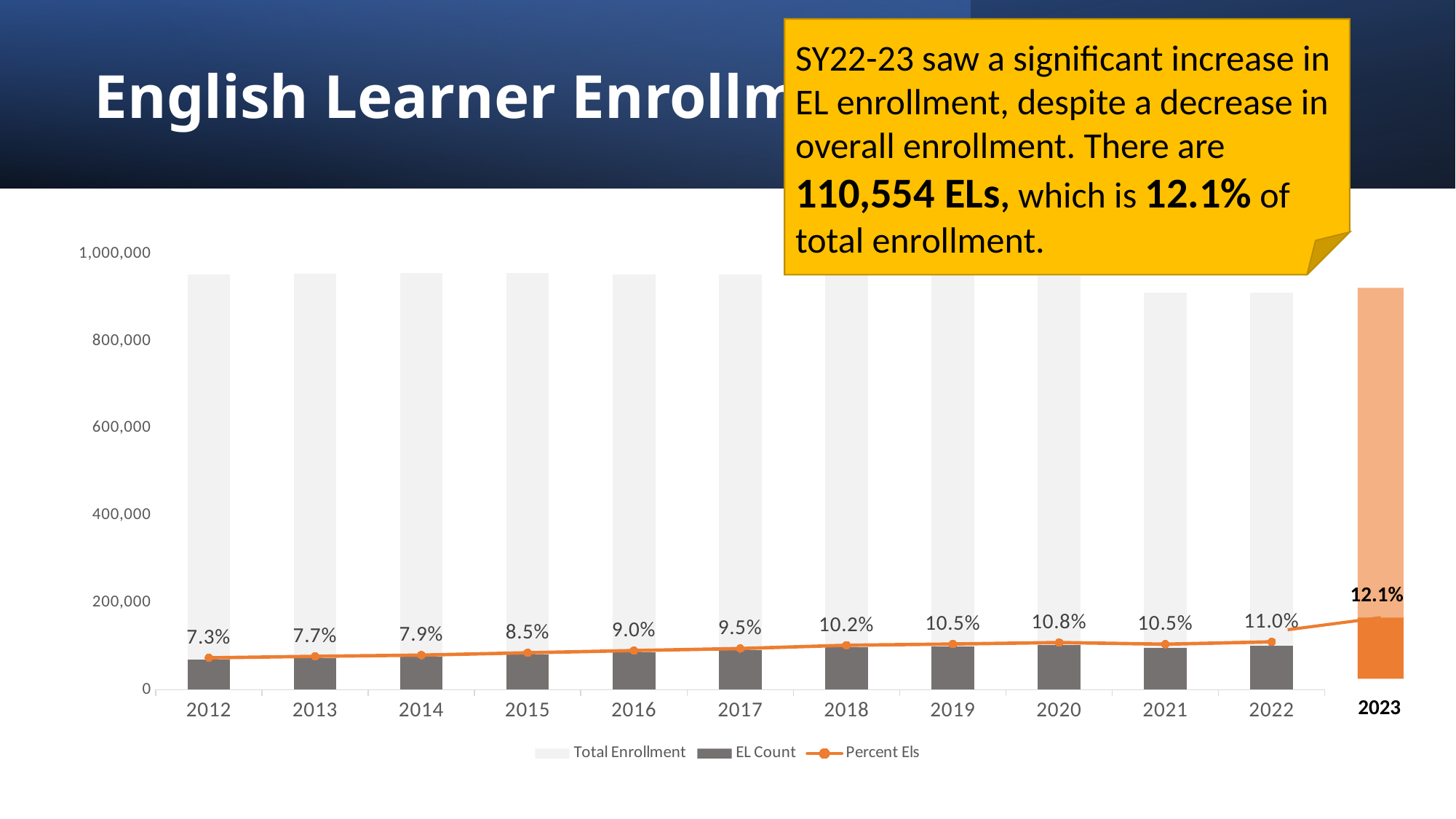
Is the Total Enrollment value for 2012 greater or less than 800,000? greater What is the Percent ELs value for 2012? 7.3% Which year has the highest Percent ELs value? 2023 What is the Percent ELs value shown for 2023? 12.1% How many series does the legend list? 3 Which series in the legend is drawn as a line with markers? Percent Els Is the EL Count value for 2022 greater or less than 200,000? less Which year has a higher Percent ELs value, 2020 or 2021? 2020 Does the Percent ELs line rise or fall from 2012 to 2020? rise Which year has the lowest Percent ELs value? 2012 What is the difference in Percent ELs between 2022 and 2012? 3.7% What is the Percent ELs value for 2022? 11.0%